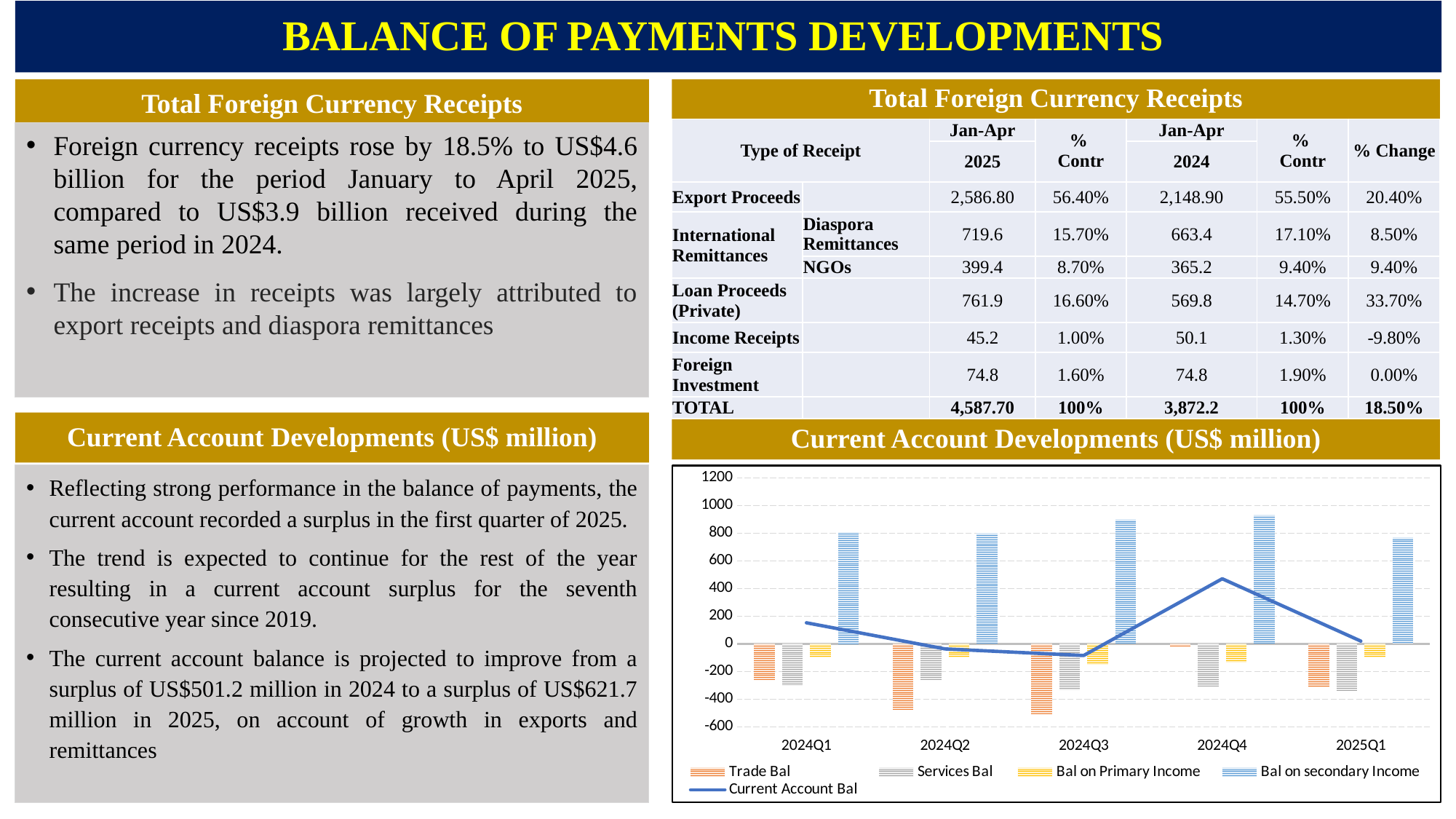
In the Current Account Developments chart, is the Trade Bal value for 2024Q1 greater or less than -200? less In the Current Account Developments chart, which is larger: Bal on secondary Income in 2024Q4 or in 2025Q1? 2024Q4 In the Current Account Developments chart, is the Current Account Bal value for 2024Q4 greater or less than 400? greater In the Current Account Developments chart, is the value of Bal on secondary Income for 2024Q4 greater or less than 800? greater How many quarters are shown on the x axis of the Current Account Developments chart? 5 How many series does the legend of the Current Account Developments chart list? 5 What kind of chart is the Current Account Developments chart? Combination bar and line chart Which series in the Current Account Developments chart is plotted as a line rather than bars? Current Account Bal In the Current Account Developments chart, in which quarter does the Current Account Bal line reach its highest point? 2024Q4 In the Current Account Developments chart, which is larger: Trade Bal in 2024Q4 or in 2024Q3? 2024Q4 In the Current Account Developments chart, does the Current Account Bal line rise or fall from 2024Q4 to 2025Q1? fall